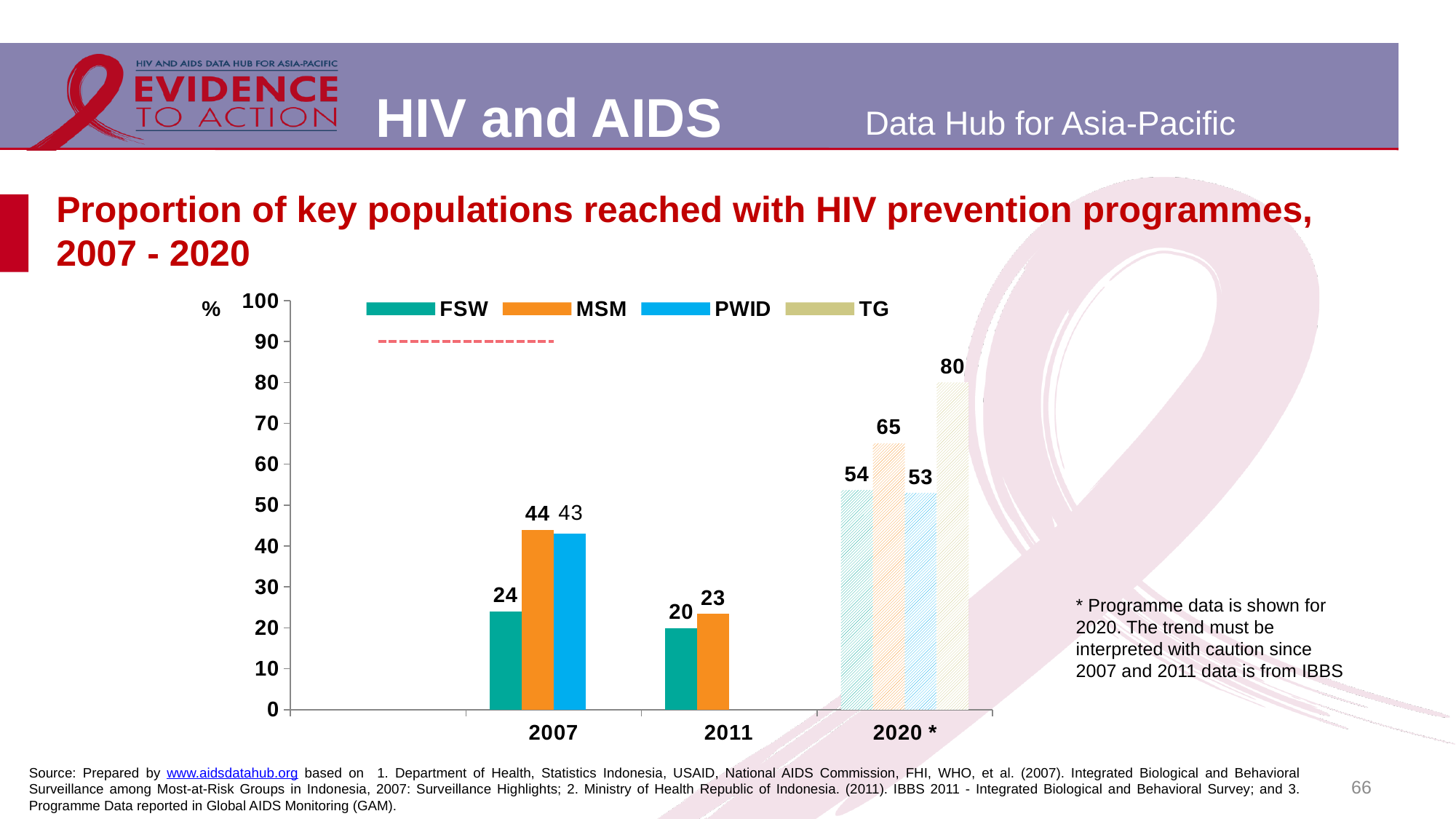
Which is larger, the FSW value in 2007 or the FSW value in 2011? FSW in 2007 What is the difference between the TG and PWID values in 2020 *? 27 What is the difference between the MSM and FSW values in 2011? 3 What is the value for TG in 2020 *? 80 How many series does the legend list? 4 Which key population has the highest value in 2020 *? TG What kind of chart is shown on the slide? Bar chart What is the value for FSW in 2007? 24 Which key population has the lowest value in 2007? FSW How does the MSM value change from 2011 to 2020 *? It rises What is the value for MSM in 2020 *? 65 What is the value for PWID in 2007? 43